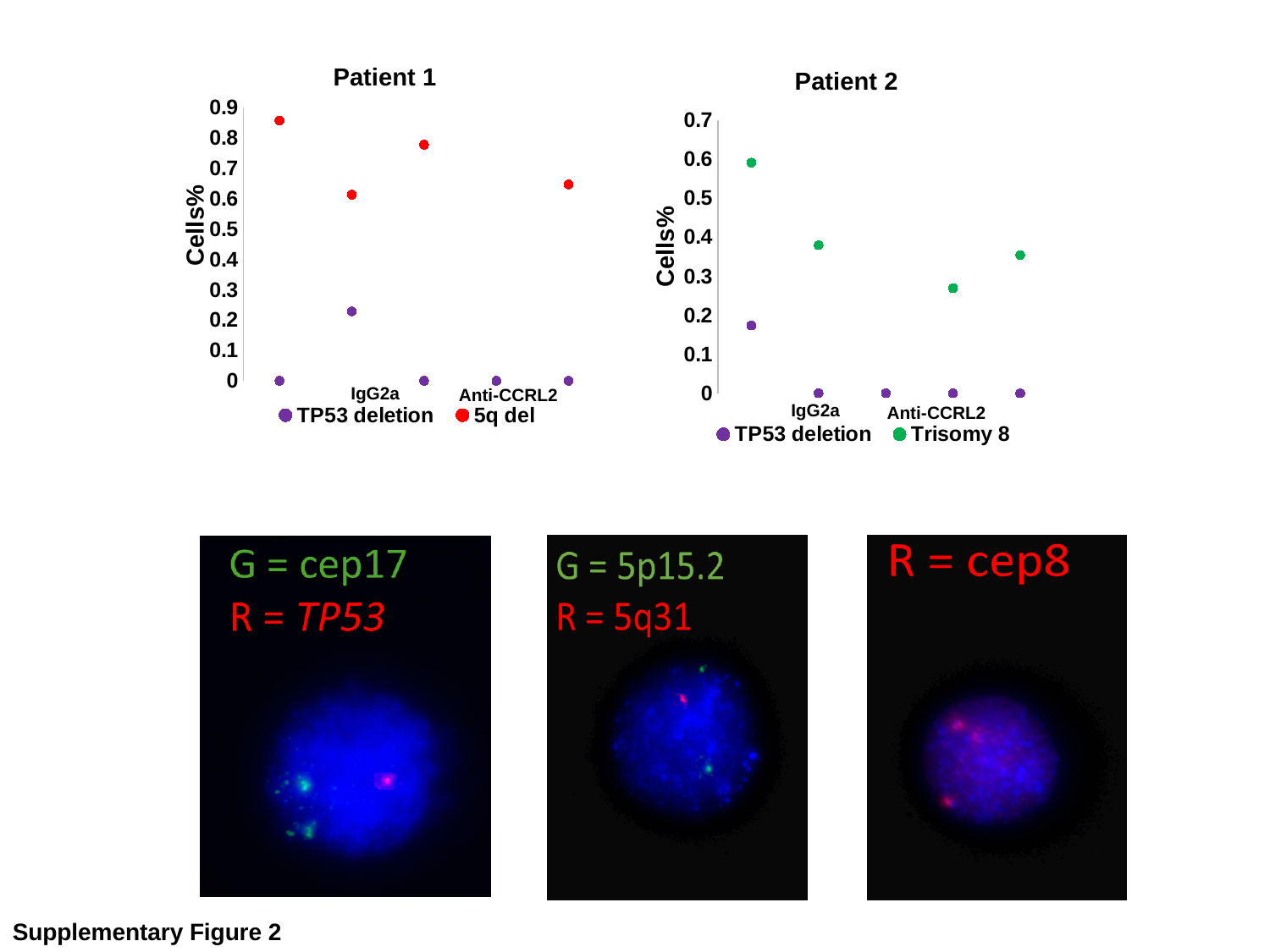
In the Patient 2 chart, is the lowest Trisomy 8 value greater or less than 0.3? less In the Patient 1 chart, is the lowest 5q del value greater or less than 0.5? greater How many series does the legend of the Patient 1 chart list? 2 In the Patient 1 chart, which series has the higher maximum value, TP53 deletion or 5q del? 5q del What are the two series named in the legend of the Patient 2 chart? TP53 deletion and Trisomy 8 What kind of chart is the Patient 1 chart? scatter chart In the Patient 1 chart, is the highest 5q del value greater or less than 0.8? greater How many Trisomy 8 points are plotted in the Patient 2 chart? 4 What is the y-axis label on the Patient 2 chart? Cells%